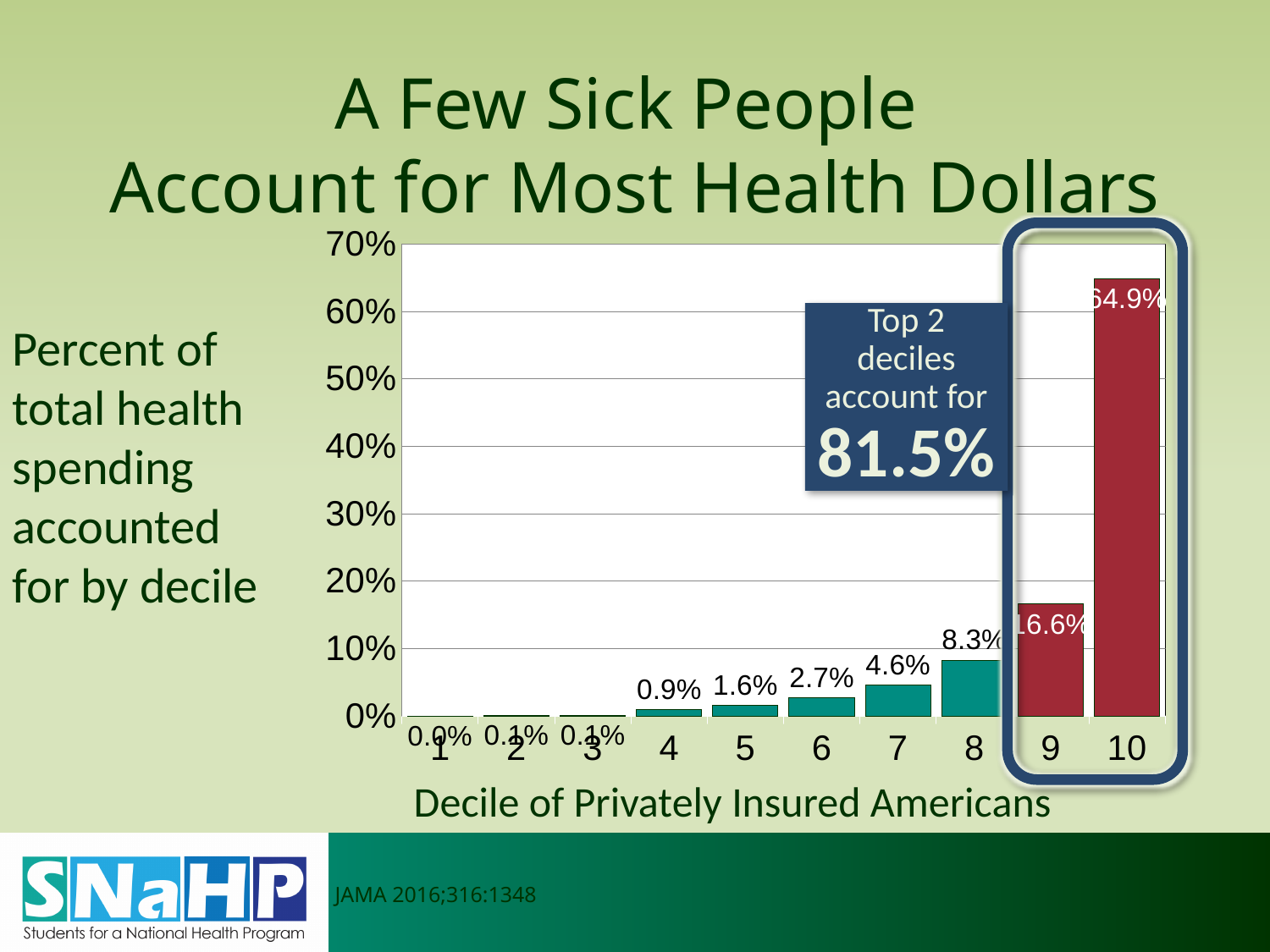
What percent of total health spending is accounted for by decile 8? 8.3% Which decile has the lowest value on the chart? 1 Is the value for decile 9 greater or less than 20%? less According to the callout on the chart, what share of spending do the top 2 deciles account for? 81.5% How many deciles are plotted on the x axis? 10 Is the value for decile 10 greater or less than 60%? greater What is the difference between the values for decile 8 and decile 7? 3.7% What is the value shown for decile 6? 2.7% What is the value shown for decile 4? 0.9% Which has a higher value, decile 5 or decile 6? Decile 6 Which decile accounts for the largest share of total health spending? 10 What kind of chart is shown on the slide? Bar chart